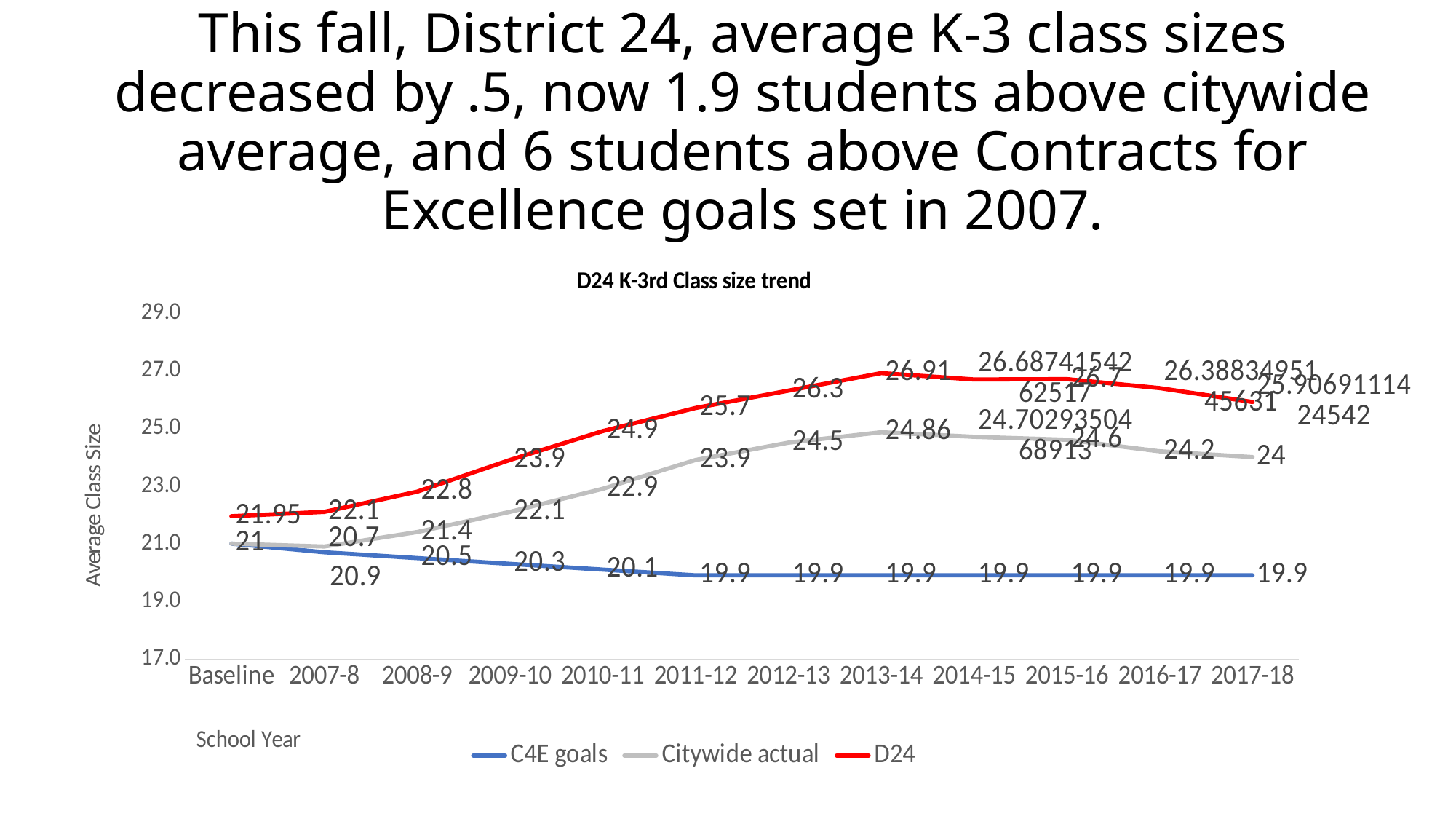
What is the difference between the D24 value and the Citywide actual value in 2011-12? 1.8 How many school-year categories are shown on the x axis? 12 How many series does the legend list? 3 What kind of chart is shown on the slide? line chart What is the D24 value at Baseline? 21.95 What is the Citywide actual value for 2013-14? 24.86 What is the D24 value for 2013-14? 26.91 In which school year does the D24 series reach its highest value? 2013-14 What colour is the D24 line in the legend? red Is the Citywide actual value for 2017-18 greater or less than 25.0? less What is the C4E goals value for 2017-18? 19.9 Which is larger in 2010-11, the D24 value or the Citywide actual value? D24